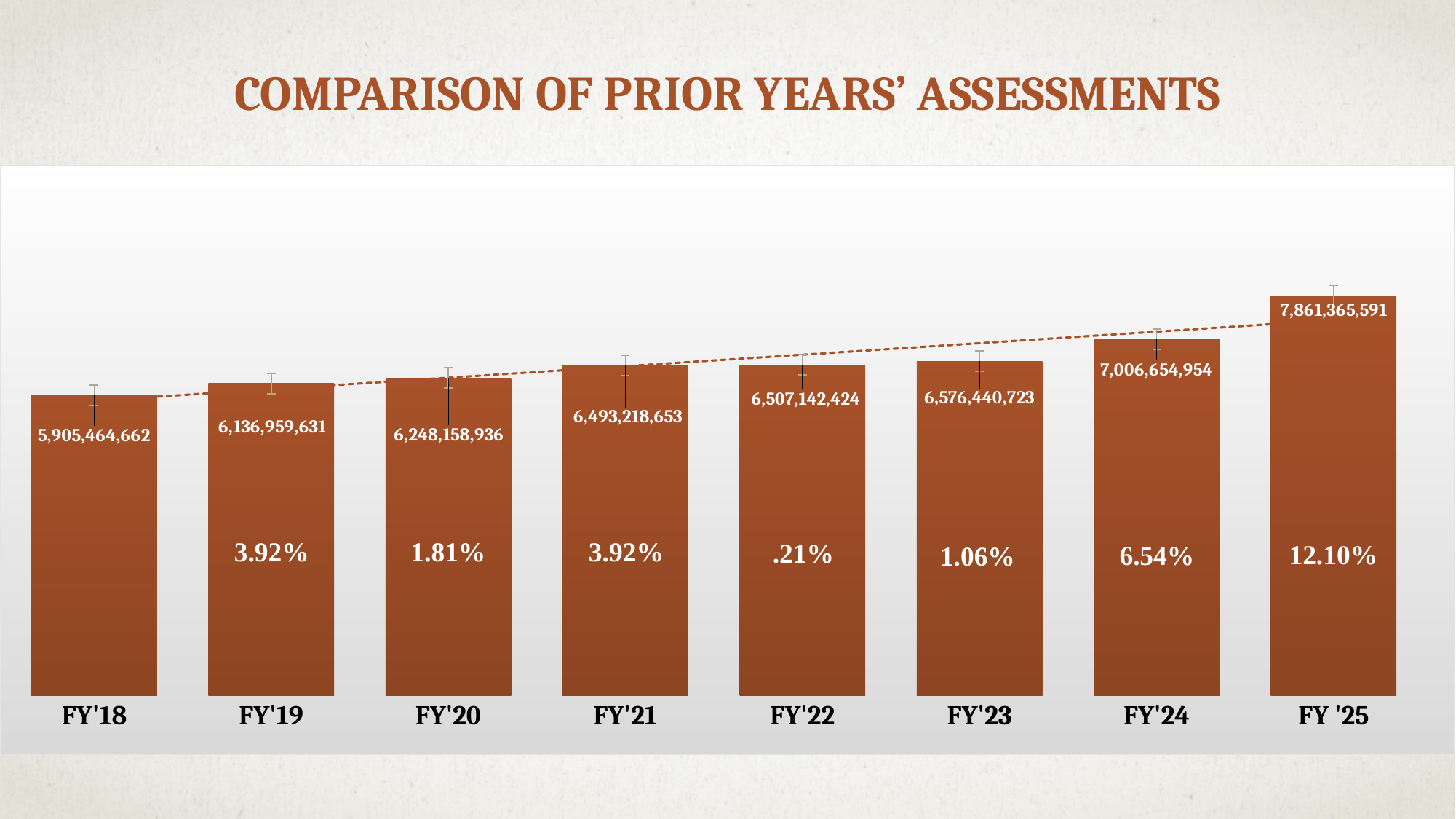
What percentage change is shown on the FY'25 bar? 12.10% What is the difference between the FY'25 and FY'24 assessment values? 854,710,637 Which fiscal year has the highest assessment value? FY '25 What percentage change is shown on the FY'22 bar? .21% Do the assessment values rise or fall from FY'18 to FY'25? Rise Which fiscal year has the lowest assessment value? FY'18 What kind of chart is shown on the slide? Bar chart What is the assessment value shown for FY'18? 5,905,464,662 What is the assessment value shown for FY'24? 7,006,654,954 What is the difference between the FY'19 and FY'18 assessment values? 231,494,969 How many fiscal years are shown in the chart? 8 Which has the larger assessment value, FY'20 or FY'23? FY'23